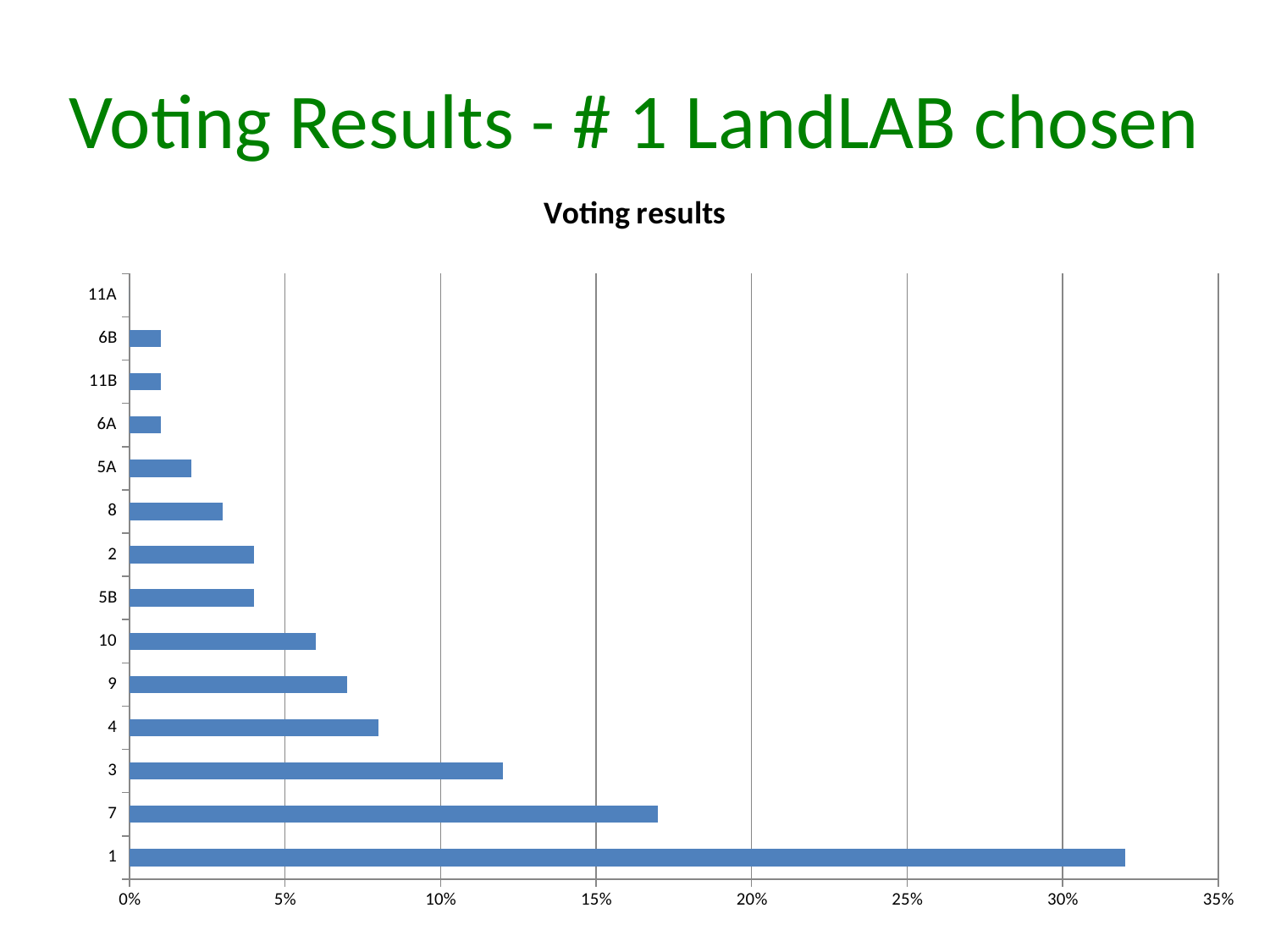
What is the title of the chart? Voting results Is the value for category 1 greater or less than 30%? greater Which has the larger value, category 10 or category 2? 10 What kind of chart is shown on the slide? bar chart Is the value for category 4 greater or less than 10%? less Which category has the highest value? 1 Is the value for category 7 greater or less than 15%? greater How many categories are plotted in the chart? 14 Which has the larger value, category 7 or category 3? 7 Which category has the lowest value? 11A